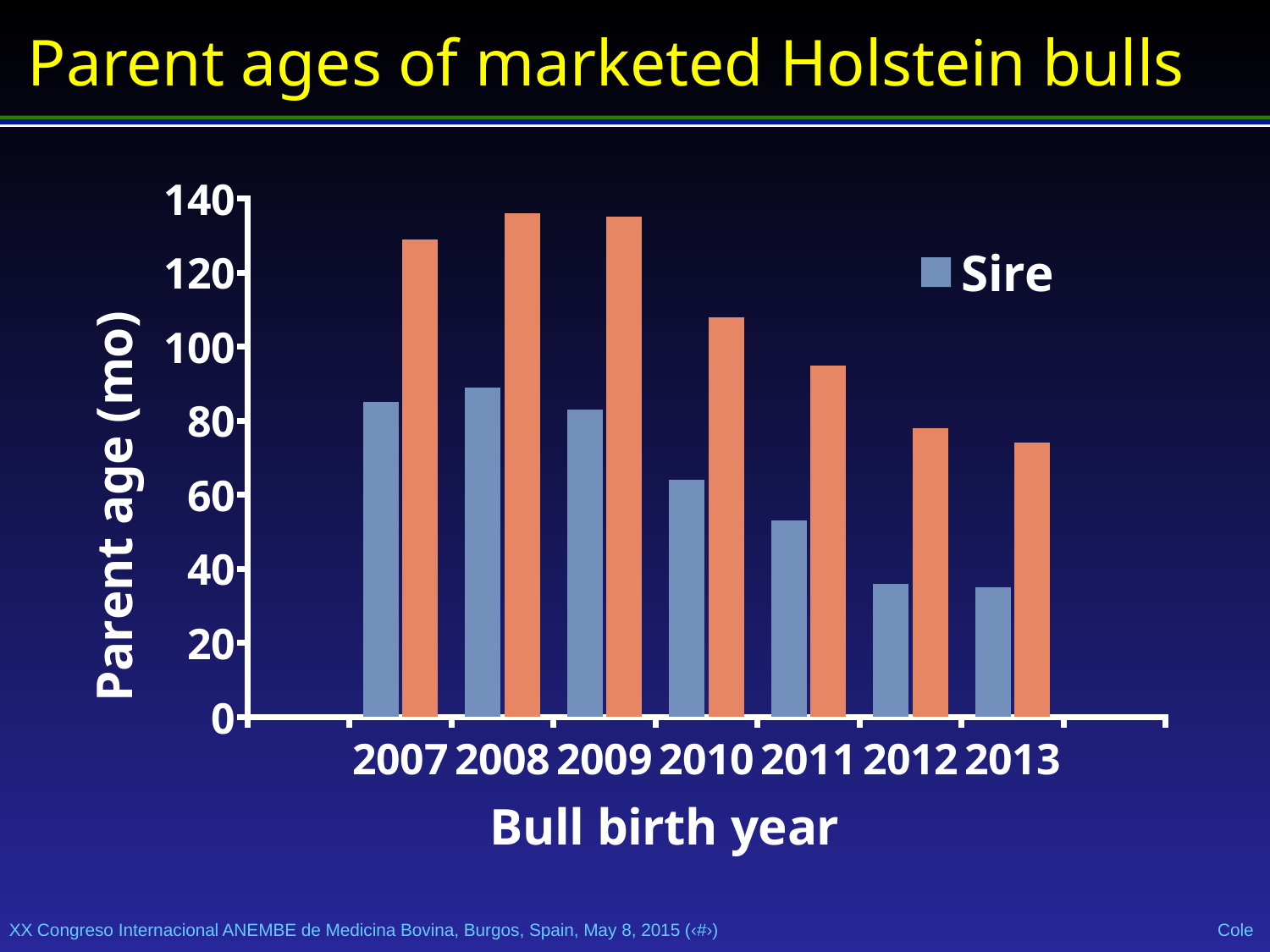
Is the orange bar for 2007 greater or less than 120? greater Do the Sire values generally rise or fall from 2007 to 2013? fall How many bull birth years are shown on the x axis? 7 What kind of chart is shown on the slide? bar chart Is the Sire value for 2007 greater or less than 80? greater Which series is named in the chart legend? Sire Is the Sire value for 2010 greater or less than 60? greater Which bull birth year has the highest Sire value? 2008 What is the title of the y axis? Parent age (mo)